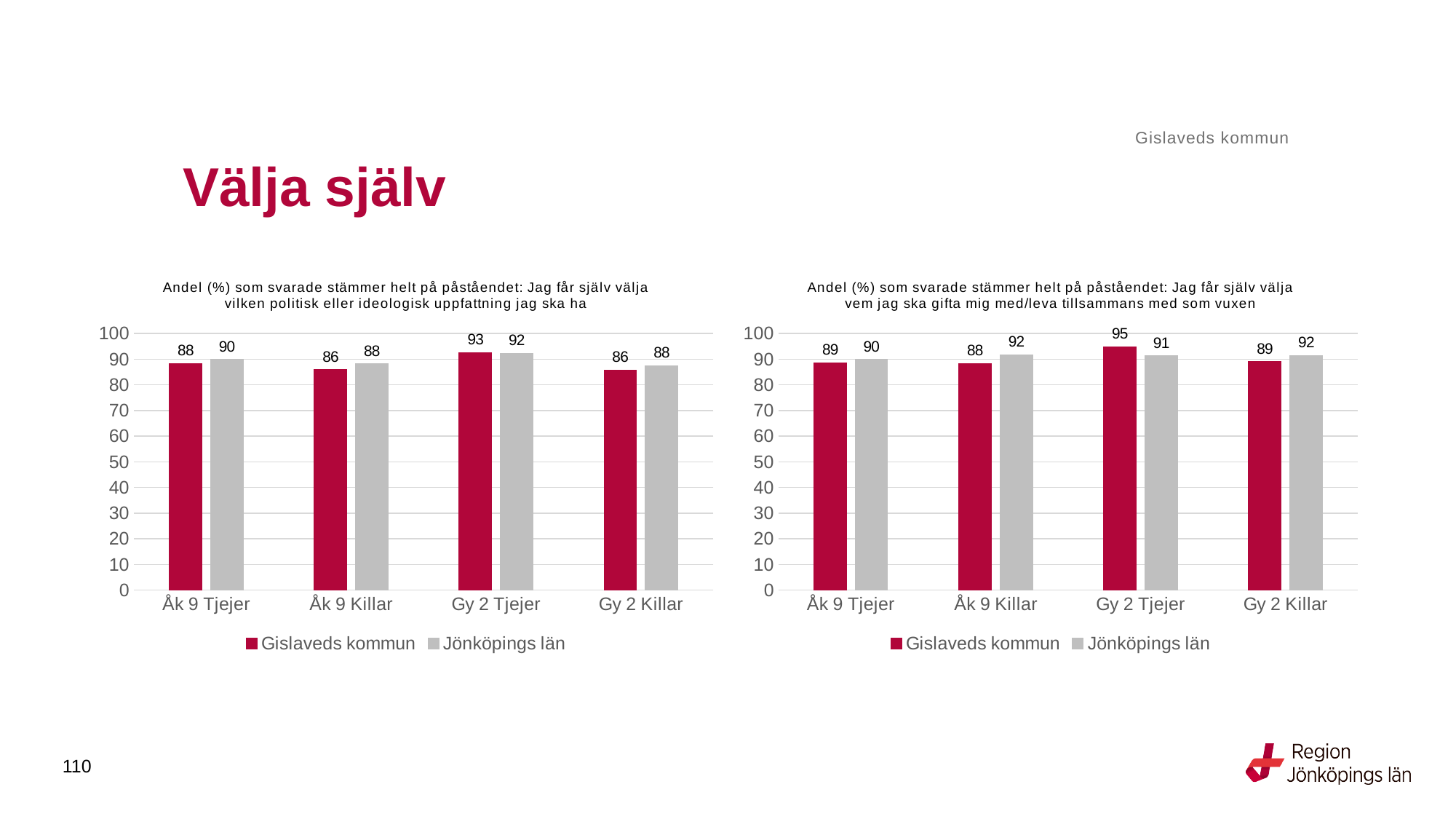
In the left chart (political or ideological opinion), which is larger for Gy 2 Tjejer: Gislaveds kommun or Jönköpings län? Gislaveds kommun In the right chart (whom to marry/live with), which category has the lowest value for Gislaveds kommun? Åk 9 Killar In the left chart (political or ideological opinion), what is the value for Gislaveds kommun for Gy 2 Tjejer? 93 In the left chart (political or ideological opinion), what is the value for Jönköpings län for Åk 9 Killar? 88 How many categories are shown on the x axis of the left chart? 4 What type of chart is the left chart? Bar chart In the right chart (whom to marry/live with), what is the difference between Jönköpings län and Gislaveds kommun for Åk 9 Killar? 4 In the left chart (political or ideological opinion), which category has the highest value for Gislaveds kommun? Gy 2 Tjejer In the right chart (whom to marry/live with), what is the value for Jönköpings län for Åk 9 Killar? 92 How many series does the legend of the right chart list? 2 In the right chart (whom to marry/live with), what is the value for Gislaveds kommun for Gy 2 Tjejer? 95 In the right chart (whom to marry/live with), which is larger for Gy 2 Killar: Gislaveds kommun or Jönköpings län? Jönköpings län